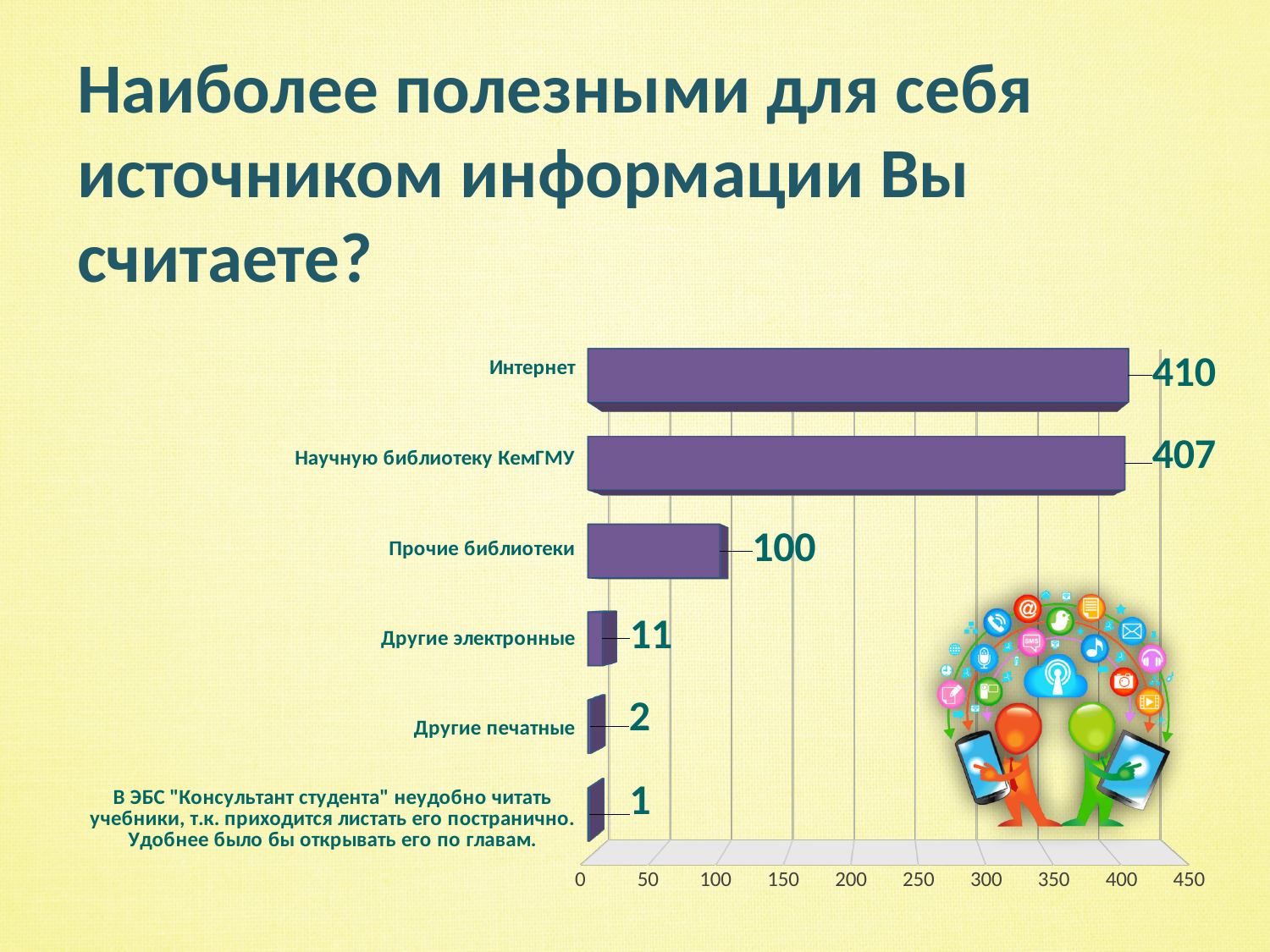
Which is larger, the value for Прочие библиотеки or the value for Другие печатные? Прочие библиотеки Which category has the highest value? Интернет What is the difference between the values for Прочие библиотеки and Другие электронные? 89 What value is shown for Научную библиотеку КемГМУ? 407 What value is shown for Прочие библиотеки? 100 What value is shown for Другие электронные? 11 How many categories are shown in the chart? 6 Which category has the lowest value? В ЭБС "Консультант студента" неудобно читать учебники, т.к. приходится листать его постранично. Удобнее было бы открывать его по главам. What kind of chart is shown on the slide? Bar chart What value is shown for Интернет? 410 What value is shown for Другие печатные? 2 What is the difference between the values for Интернет and Научную библиотеку КемГМУ? 3